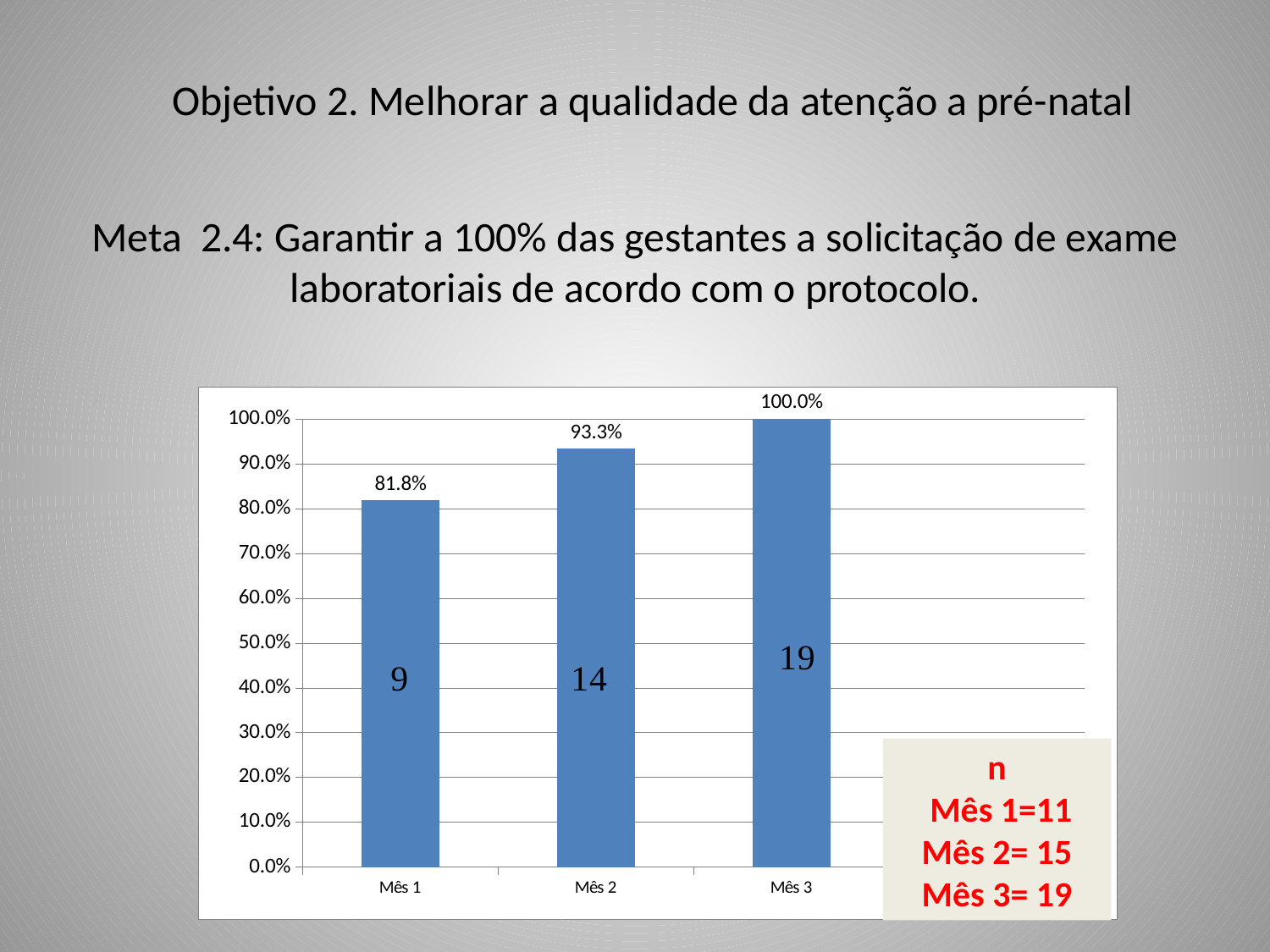
What is the value for Mês 1? 81.8% Which is larger, the value for Mês 1 or the value for Mês 2? Mês 2 Which month has the lowest value? Mês 1 What is the difference between the values for Mês 2 and Mês 1? 11.5% How many categories are shown on the x axis? 3 What is the value for Mês 2? 93.3% What number is printed inside the bar for Mês 2? 14 What is the value for Mês 3? 100.0% Which month has the highest value? Mês 3 What is the difference between the values for Mês 3 and Mês 1? 18.2% Do the values rise or fall from Mês 1 to Mês 3? Rise What kind of chart is shown on the slide? Bar chart